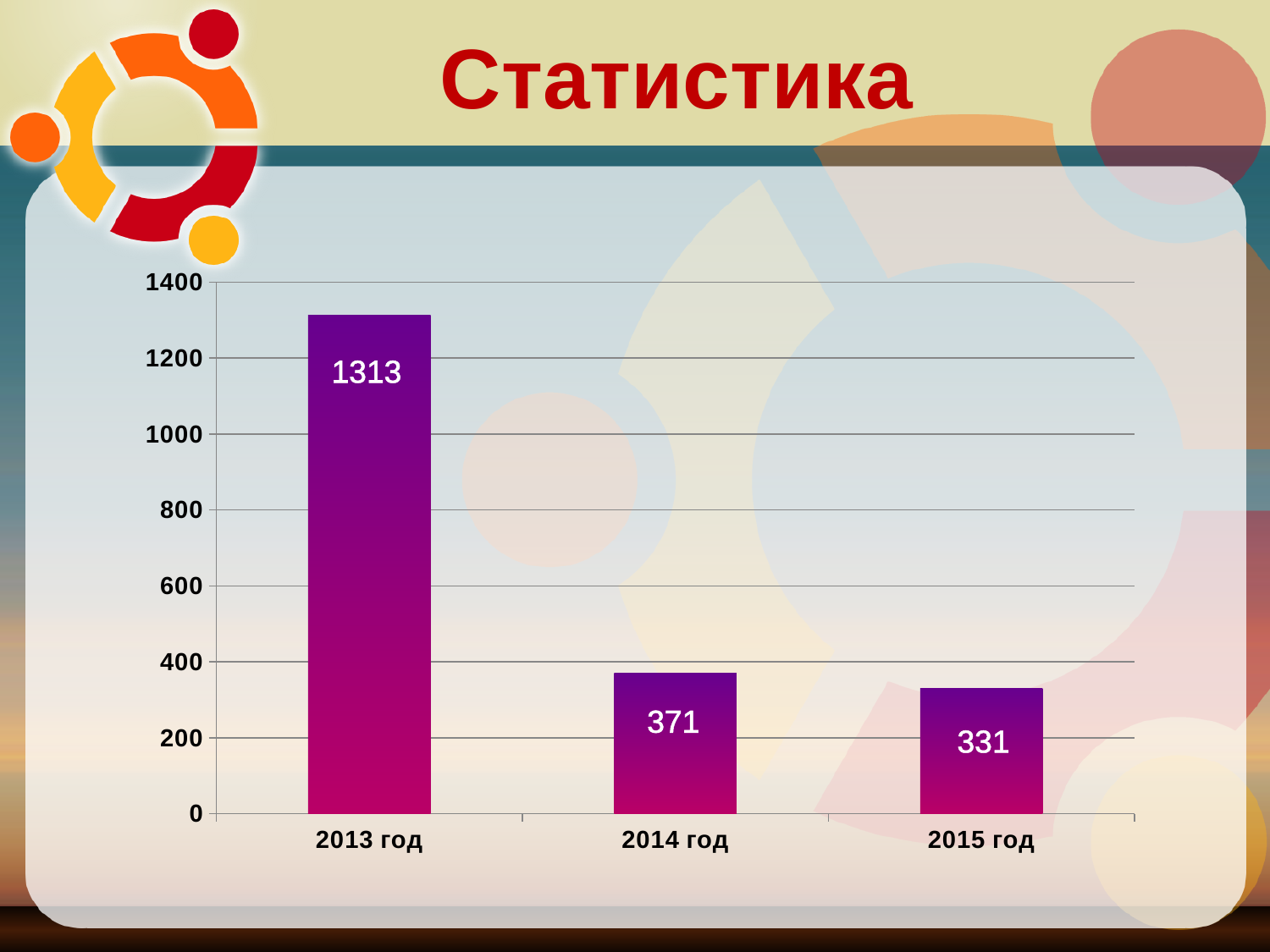
Which is larger, the value for 2014 год or 2015 год? 2014 год What is the difference between the values for 2013 год and 2014 год? 942 What is the difference between the values for 2014 год and 2015 год? 40 Which year has the highest value? 2013 год How many categories are shown on the x axis? 3 What kind of chart is shown on the slide? bar chart Which year has the lowest value? 2015 год What is the value for 2015 год? 331 Is the value for 2013 год greater or less than 1200? greater Do the values rise or fall from 2013 год to 2015 год? fall What is the value for 2014 год? 371 What is the value for 2013 год? 1313